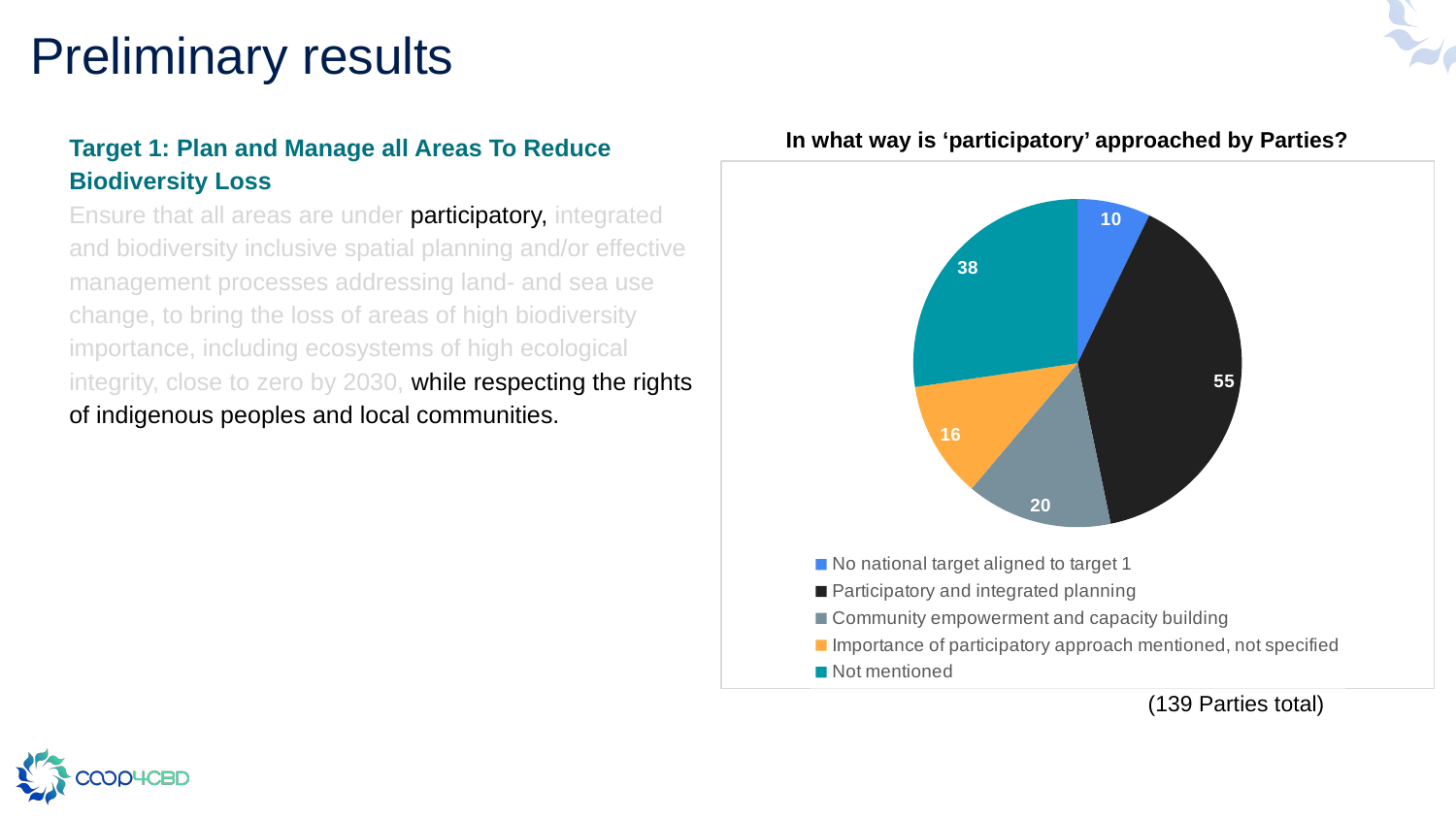
What is the value for 'Not mentioned'? 38 Which category has the largest slice of the pie? Participatory and integrated planning What type of chart is shown on the slide? Pie chart How many Parties fall under 'Participatory and integrated planning'? 55 What is the difference between 'Participatory and integrated planning' and 'Not mentioned'? 17 What is the value for 'Community empowerment and capacity building'? 20 What is the title of the pie chart? In what way is ‘participatory’ approached by Parties? What is the value for 'Importance of participatory approach mentioned, not specified'? 16 Which category has the smallest slice of the pie? No national target aligned to target 1 How many categories does the pie chart have? 5 Which is larger: 'Community empowerment and capacity building' or 'Importance of participatory approach mentioned, not specified'? Community empowerment and capacity building What is the value for 'No national target aligned to target 1'? 10